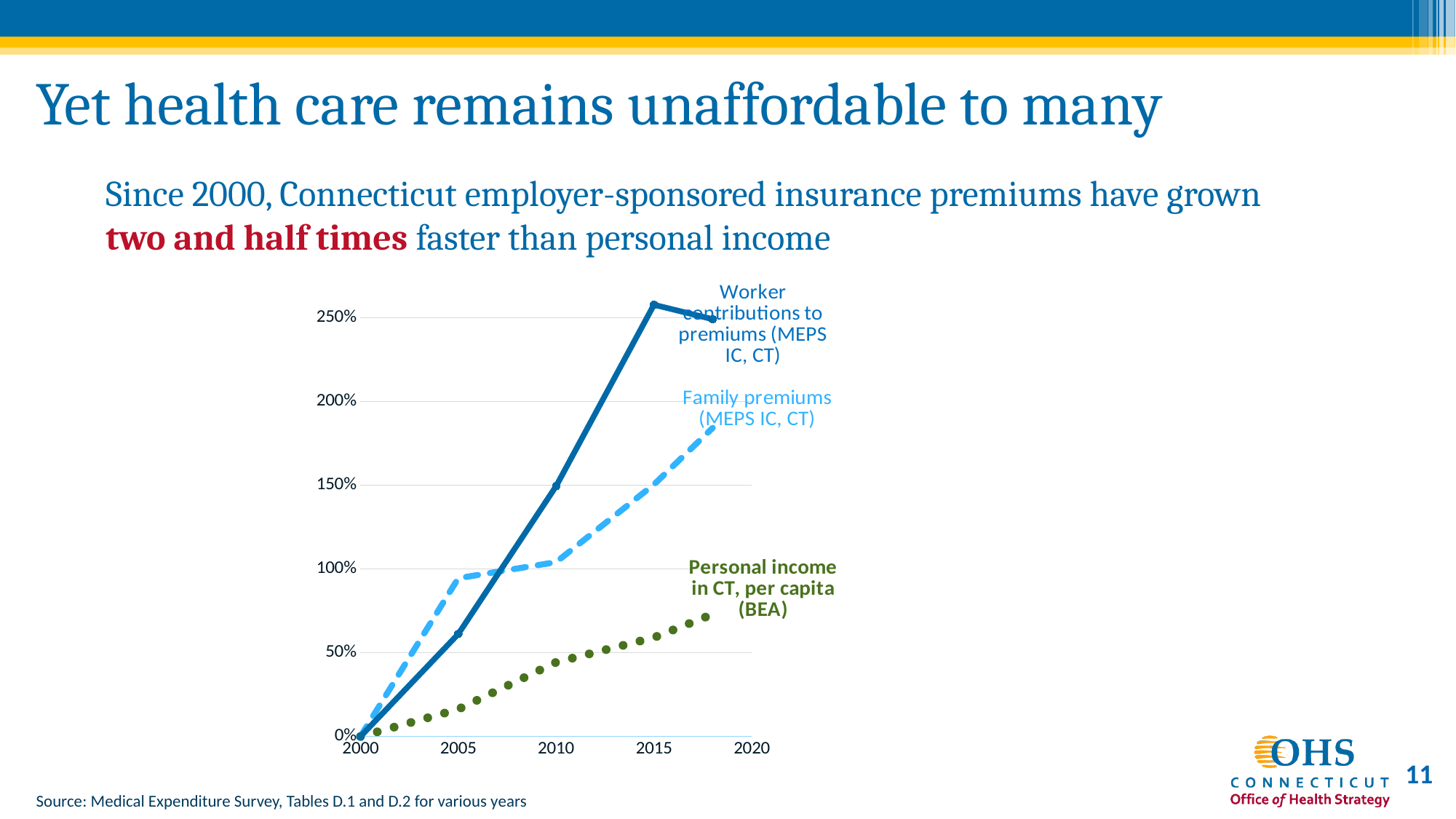
Is the value for Worker contributions to premiums in 2005 greater or less than 50%? greater Is the value for Personal income in CT, per capita in 2015 greater or less than 100%? less Which series has the lowest value at the end of the plotted period? Personal income in CT, per capita (BEA) How many year labels are shown on the x axis? 5 Does the Personal income in CT, per capita series rise or fall from 2000 onward? rise Which series has the highest value in 2015? Worker contributions to premiums (MEPS IC, CT) In 2005, which is larger: Family premiums or Worker contributions to premiums? Family premiums What kind of chart is shown on the slide? line chart Is the value for Family premiums in 2005 greater or less than 150%? less How many data series are plotted on the chart? 3 What is the highest percentage label shown on the y axis? 250%